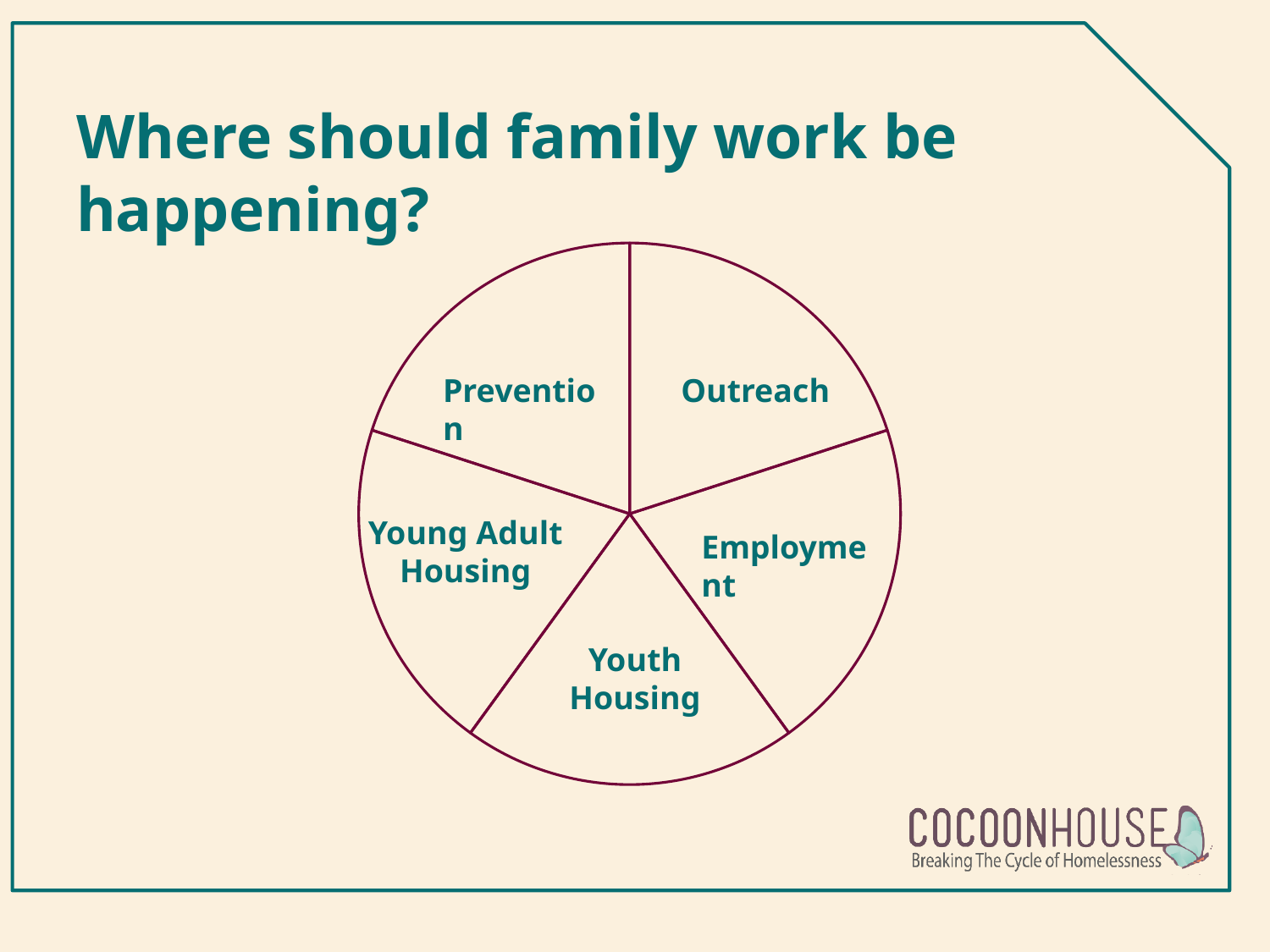
Which slice of the pie chart is located on the left side, below Prevention? Young Adult Housing Which slice of the pie chart is located on the right side, below Outreach? Employment How many slices does the pie chart have? 5 Which slice of the pie chart is labelled at the bottom, between Young Adult Housing and Employment? Youth Housing What kind of chart is shown on the slide? pie chart Which slice of the pie chart sits directly to the right of the Prevention slice, at the top of the pie? Outreach What is the title above the pie chart? Where should family work be happening?